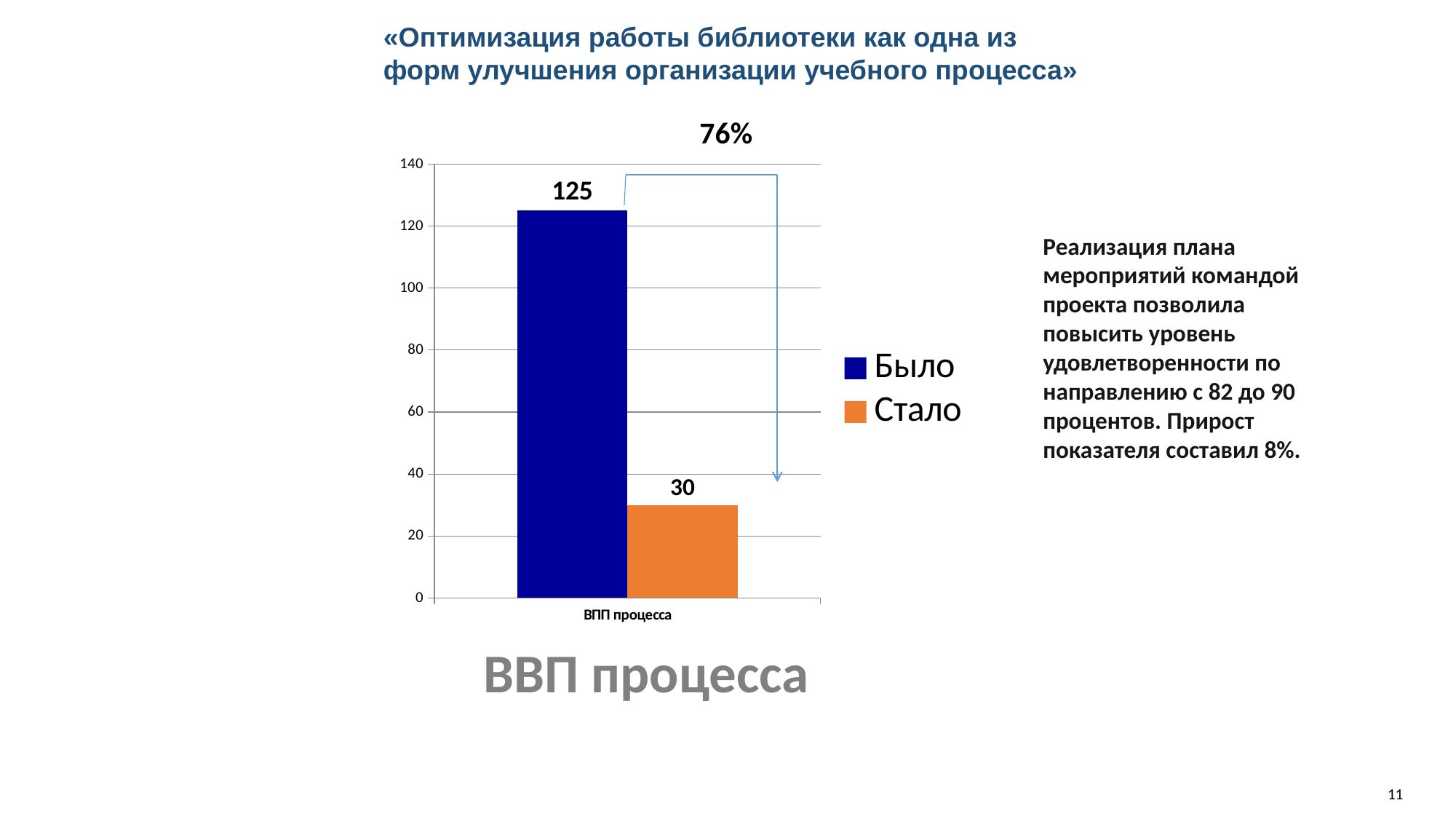
What percentage reduction is annotated above the bars? 76% Which series has the lowest value in the chart? Стало What kind of chart is shown on the slide? bar chart Is the value for 'Стало' greater or less than 40? less Is the value for 'Было' greater or less than 120? greater What is the value of the 'Было' bar for ВПП процесса? 125 Which series has the higher value, 'Было' or 'Стало'? Было What colour is the 'Стало' bar? orange What is the value of the 'Стало' bar for ВПП процесса? 30 How many series does the legend list? 2 How many categories are shown on the x axis? 1 What is the difference between the 'Было' and 'Стало' values? 95